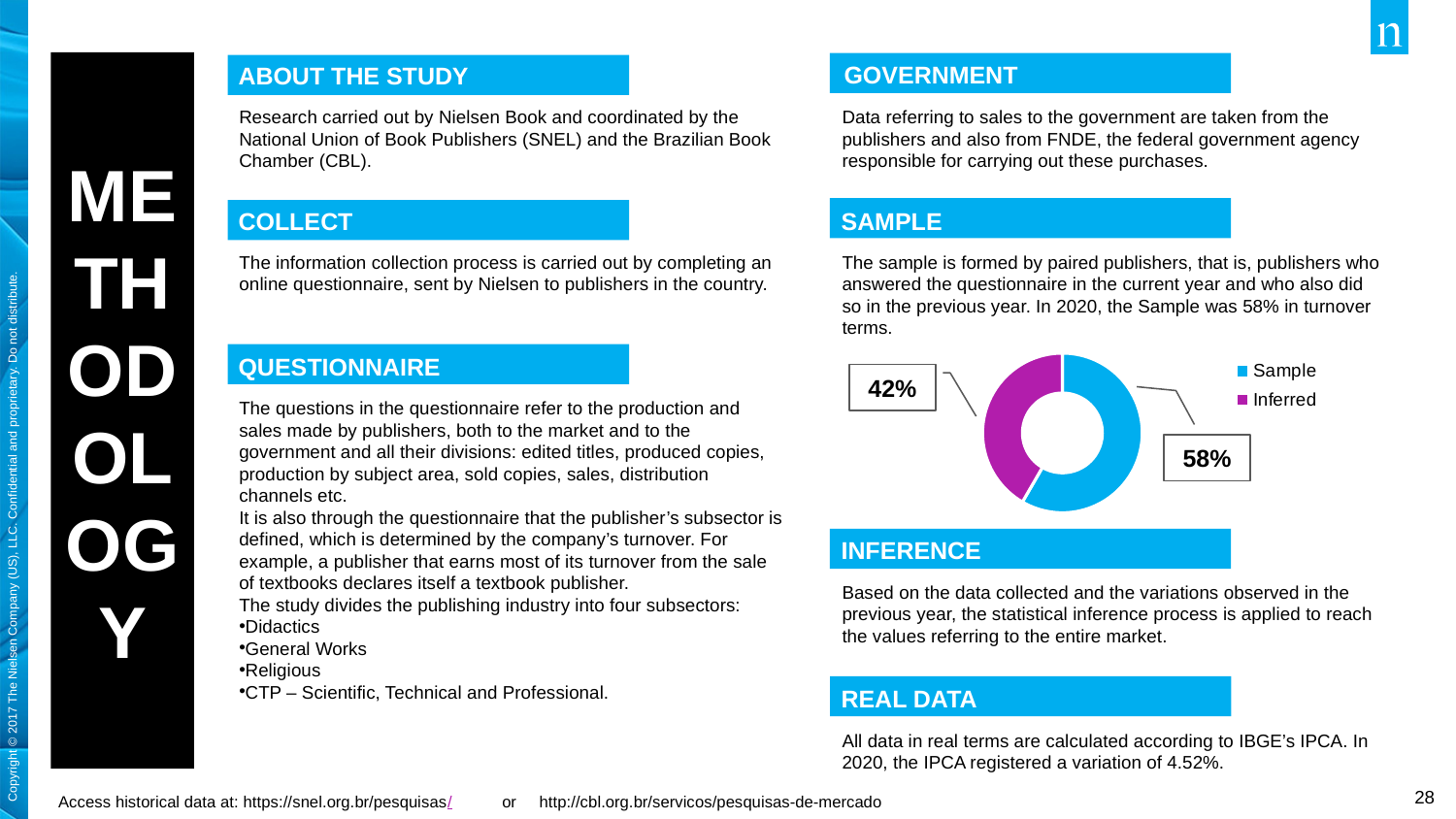
Is the Sample slice greater or less than 50% of the pie chart? greater What colour is the Inferred slice in the pie chart? purple How many slices does the pie chart have? 2 Which is larger in the pie chart, Sample or Inferred? Sample What share of the pie chart does Inferred represent? 42% What colour is the Sample slice in the pie chart? blue What kind of chart is shown on the slide? pie chart (doughnut) What share of the pie chart does Sample represent? 58% Which slice of the pie chart is the largest? Sample What is the difference in percentage points between the Sample and Inferred slices? 16 How many entries does the legend of the pie chart list? 2 Which slice of the pie chart is the smallest? Inferred